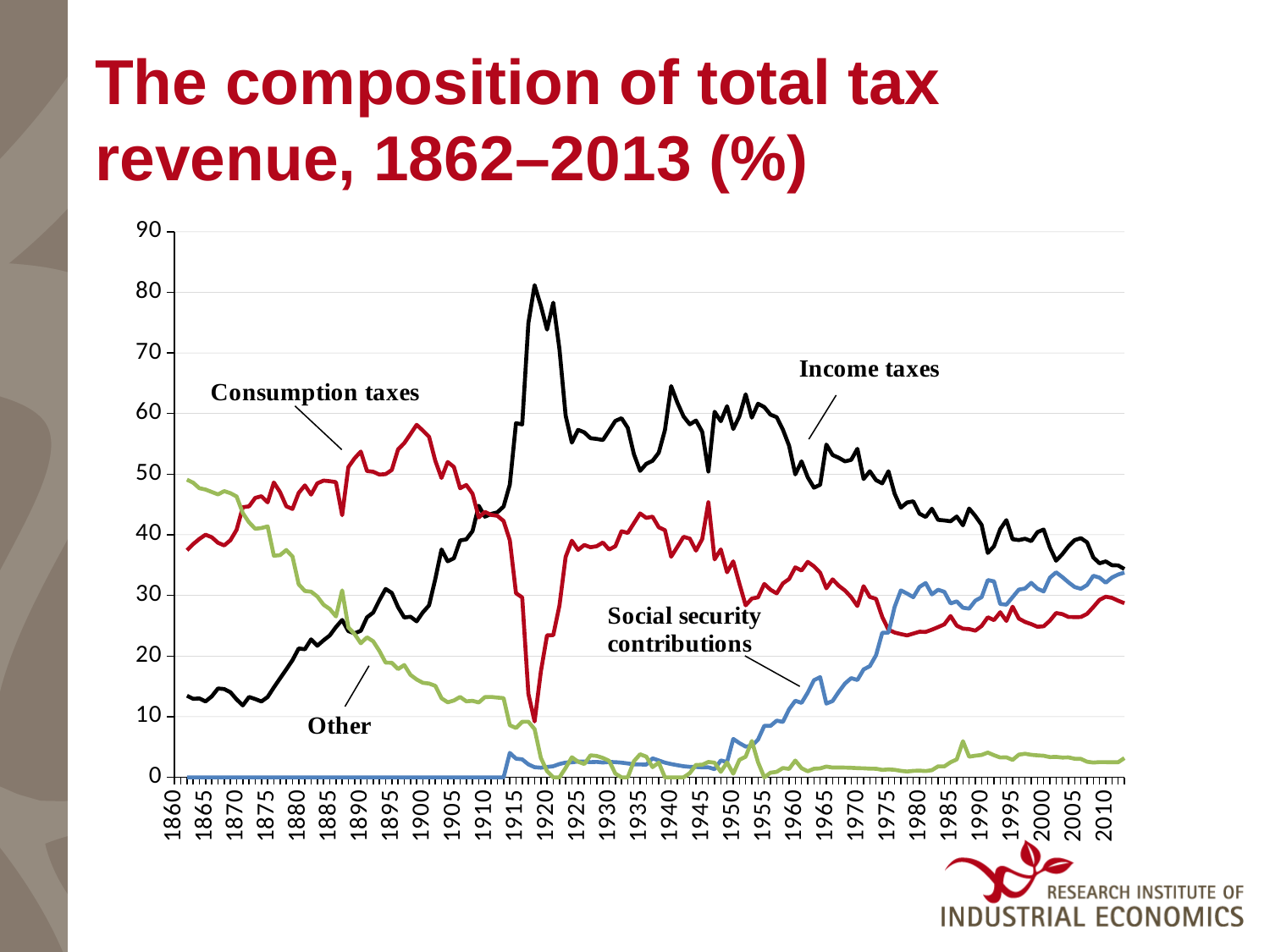
Is the value for Income taxes in 1862 greater or less than 20? less Is the value for Social security contributions in 1900 greater or less than 10? less Is the peak value of Income taxes (around 1918) greater or less than 70? greater What colour is the Income taxes line? black Does the Social security contributions series rise or fall from 1950 to 2013? rise Which series reaches the highest value anywhere on the chart? Income taxes Which series has the highest value at the start of the chart, in 1862? Other Which series has the lowest value at the end of the chart, in 2013? Other How many series are plotted on the chart? 4 What kind of chart is shown on the slide? line chart What is the title of the chart on the slide? The composition of total tax revenue, 1862–2013 (%)